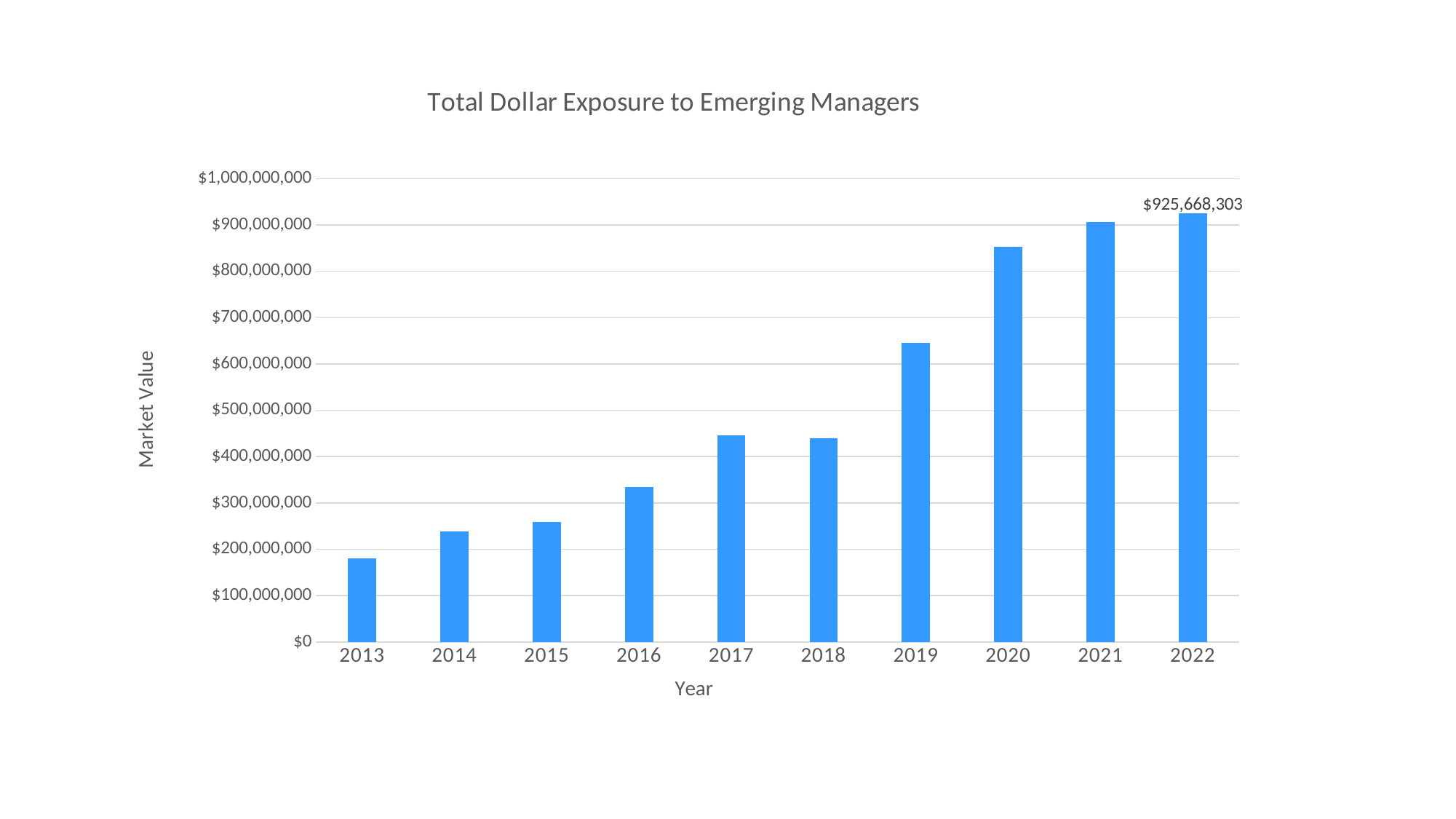
Is the value for 2019 greater or less than $600,000,000? greater Which is larger, the value for 2014 or the value for 2016? 2016 How many years are shown on the x axis? 10 Which is larger, the value for 2019 or the value for 2018? 2019 Is the value for 2016 greater or less than $300,000,000? greater Is the value for 2020 greater or less than $900,000,000? less What is the title of the chart? Total Dollar Exposure to Emerging Managers What is the value for 2022? $925,668,303 What kind of chart is shown? Bar chart Which year has the highest market value? 2022 Which year has the lowest market value? 2013